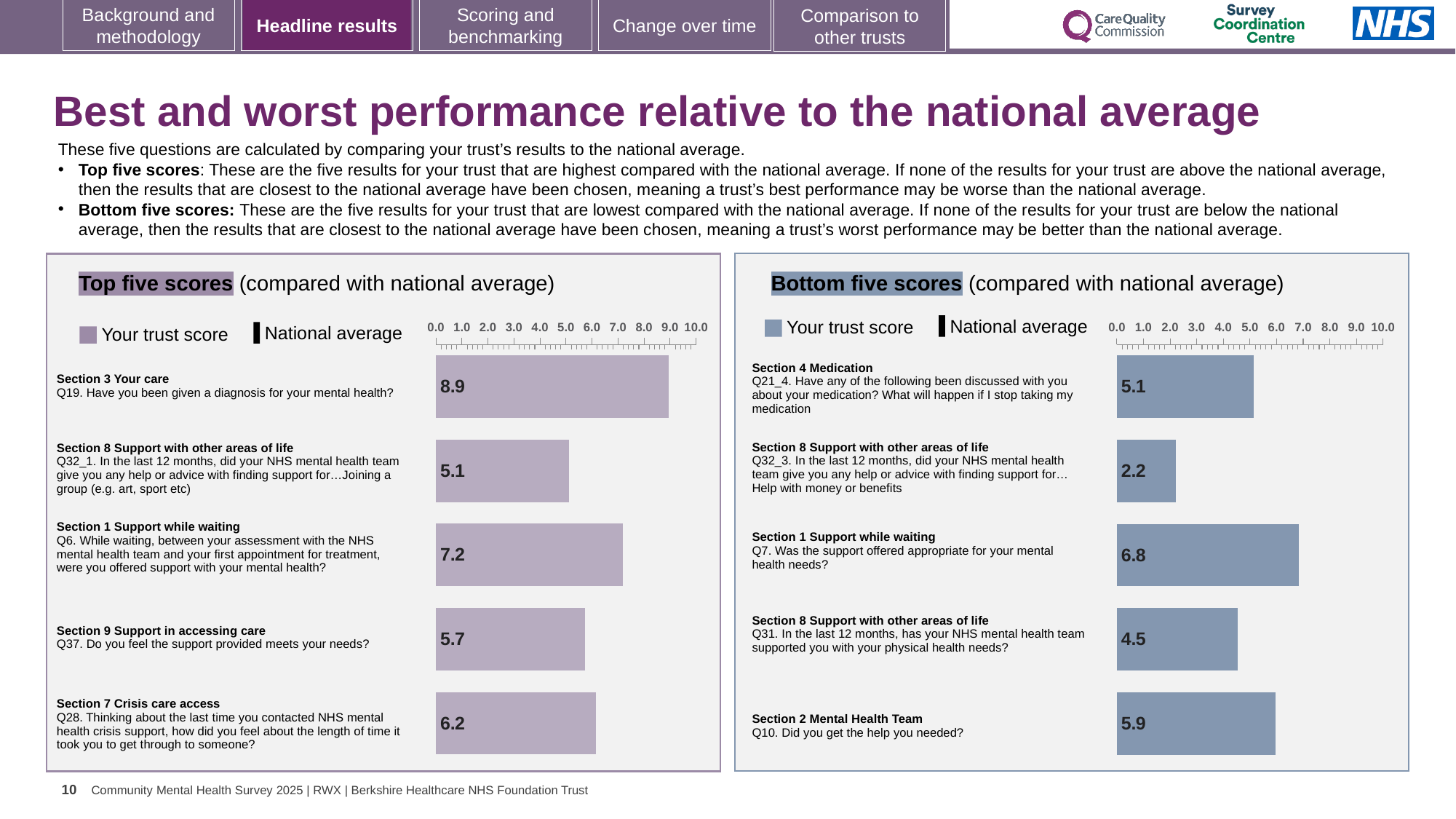
In the Top five scores chart, what is the trust score for Q19 (Have you been given a diagnosis for your mental health?)? 8.9 In the Bottom five scores chart, what is the difference between the trust scores for Q7 and Q31? 2.3 In the Bottom five scores chart, is the trust score for Q10 greater or less than 5.0? greater In the Bottom five scores chart, what is the trust score for Q32_3 (help with money or benefits)? 2.2 In the Top five scores chart, which question has the highest trust score? Q19 In the Bottom five scores chart, what is the trust score for Q21_4 (What will happen if I stop taking my medication)? 5.1 In the Bottom five scores chart, which question has the lowest trust score? Q32_3 In the Top five scores chart, which has the larger trust score, Q6 or Q37? Q6 In the Top five scores chart, what is the difference between the trust scores for Q19 and Q32_1? 3.8 What type of chart is the Top five scores chart? Bar chart How many bars are plotted in the Bottom five scores chart? 5 How many series does the legend of the Top five scores chart list? 2